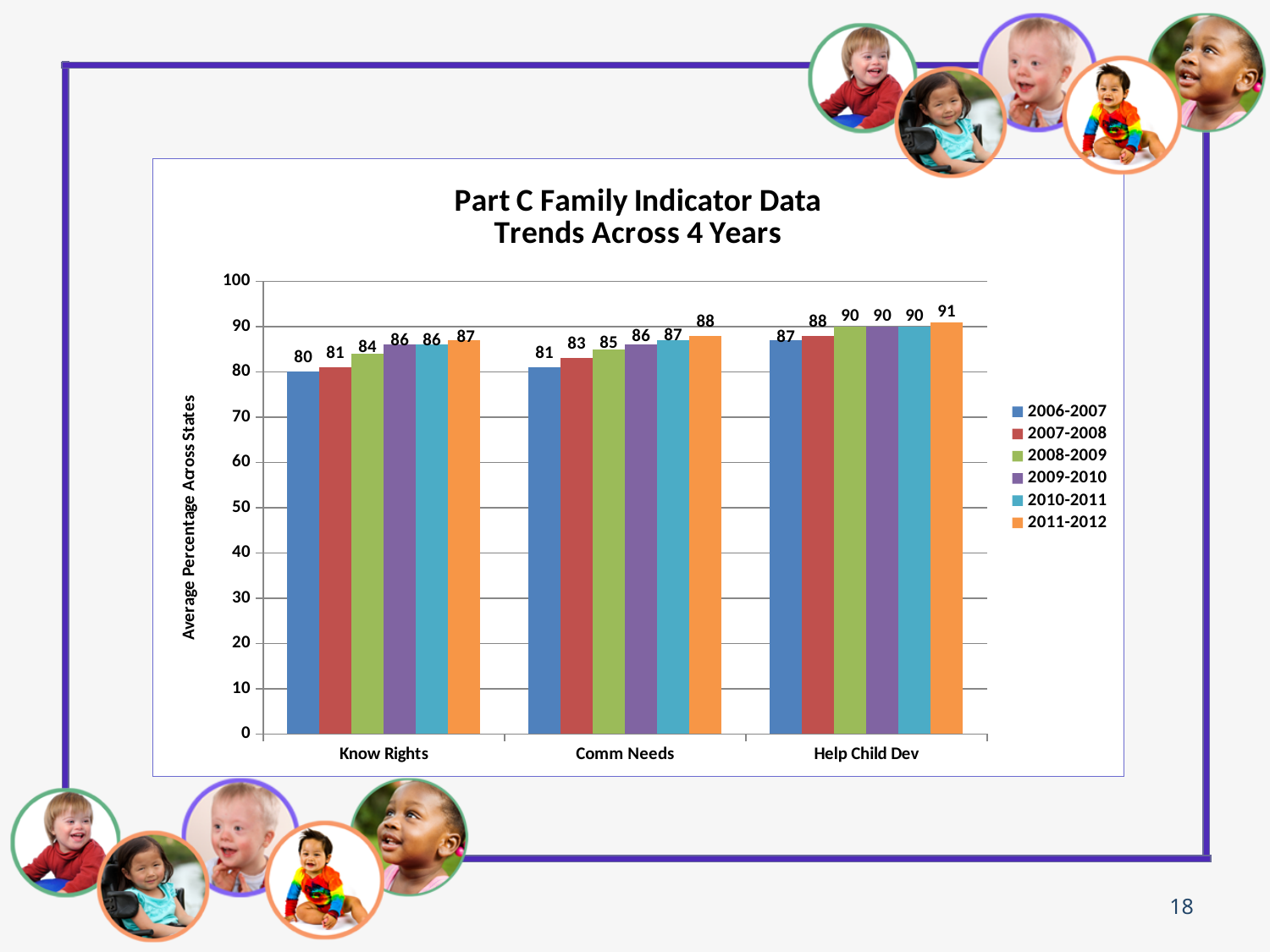
What is the difference between the 2011-2012 and 2006-2007 values for Comm Needs? 7 What is the label of the y axis? Average Percentage Across States Which category has the highest value in 2011-2012? Help Child Dev How many categories are shown on the x axis? 3 What is the value for Know Rights in 2006-2007? 80 Do the values for Help Child Dev rise or fall from 2006-2007 to 2011-2012? Rise What kind of chart is shown on the slide? Bar chart What is the value for Help Child Dev in 2011-2012? 91 How many series does the legend list? 6 What is the value for Comm Needs in 2008-2009? 85 Which category has the lowest value in 2006-2007? Know Rights Which is larger: the 2009-2010 value for Know Rights or the 2009-2010 value for Help Child Dev? Help Child Dev